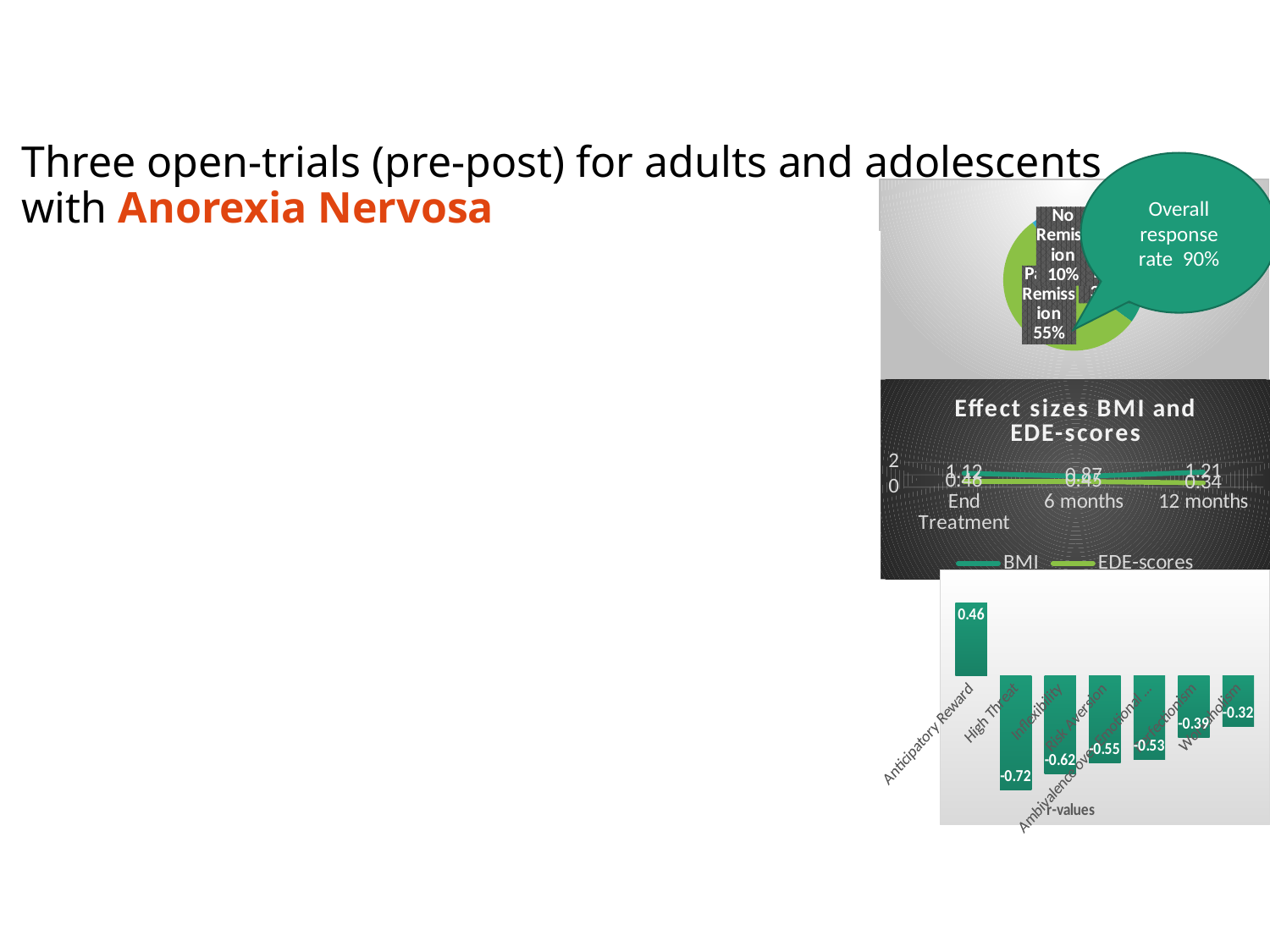
What kind of chart is the 'Effect sizes BMI and EDE-scores' chart? line chart In the 'Effect sizes BMI and EDE-scores' chart, what is the BMI effect size at 12 months? 1.21 In the 'Effect sizes BMI and EDE-scores' chart, what is the BMI effect size at End Treatment? 1.12 In the pie chart at the top right of the slide, what percentage is labelled No Remission? 10% In the 'Effect sizes BMI and EDE-scores' chart, at which time point is the BMI effect size lowest? 6 months In the 'Effect sizes BMI and EDE-scores' chart, which series has the larger value at End Treatment, BMI or EDE-scores? BMI In the 'r-values' bar chart, what is the value for Anticipatory Reward? 0.46 In the 'Effect sizes BMI and EDE-scores' chart, how many time points are shown on the x axis? 3 What kind of chart is the 'r-values' chart at the bottom right of the slide? bar chart In the 'r-values' bar chart, what is the value for High Threat? -0.72 In the 'r-values' bar chart, which category has the lowest value? High Threat In the 'Effect sizes BMI and EDE-scores' chart, how many series does the legend list? 2